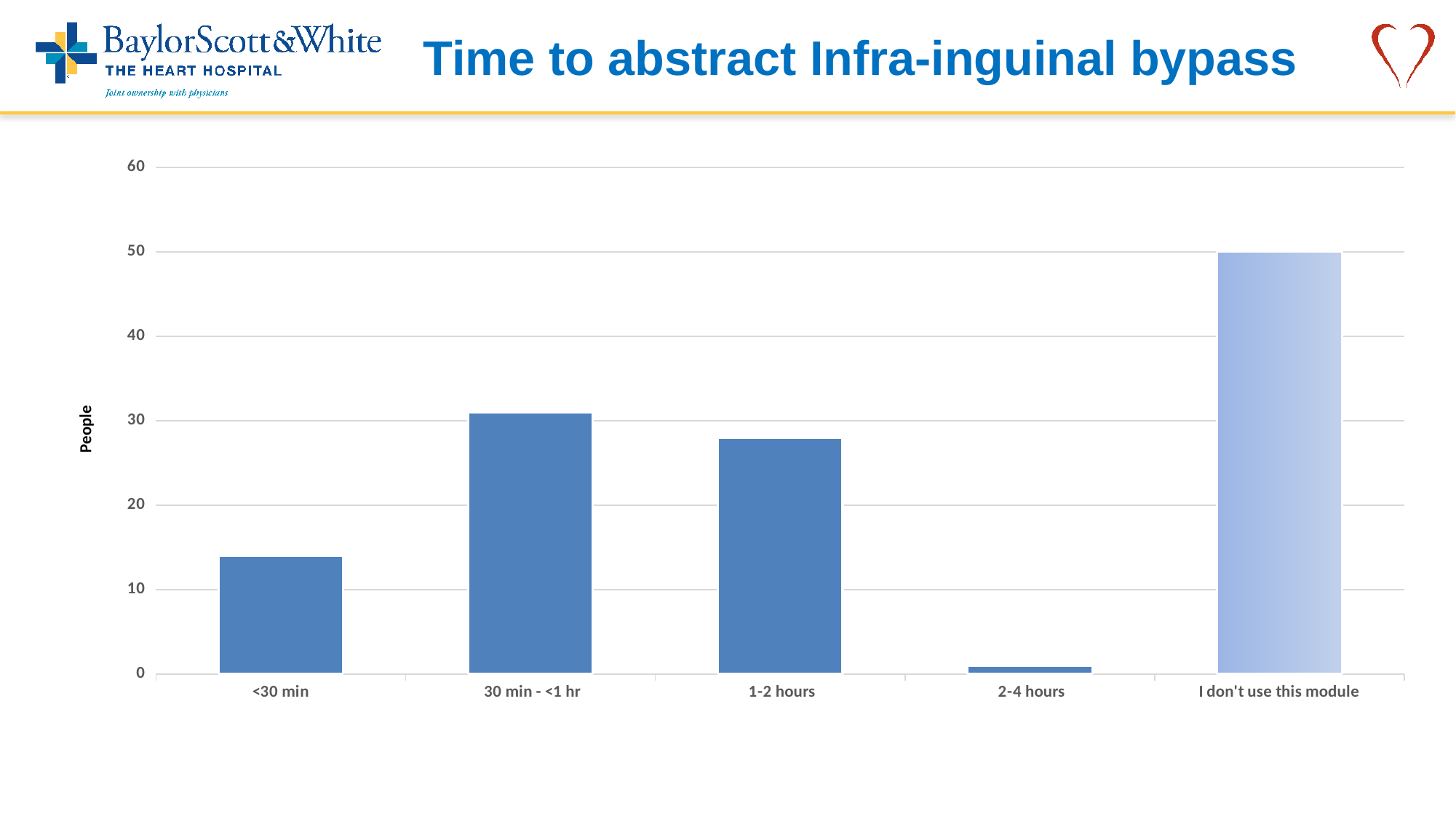
Which category has the lowest value in the chart? 2-4 hours What kind of chart is shown on the slide? bar chart Is the value for "<30 min" greater or less than 20? less What is the label on the vertical axis of the chart? People Which category has the highest value in the chart? I don't use this module Which is larger, the value for "1-2 hours" or the value for "2-4 hours"? 1-2 hours What is the title of the slide containing the chart? Time to abstract Infra-inguinal bypass Is the value for "I don't use this module" greater or less than 40? greater Is the value for "1-2 hours" greater or less than 30? less Which is larger, the value for "30 min - <1 hr" or the value for "<30 min"? 30 min - <1 hr How many categories are shown on the x axis of the chart? 5